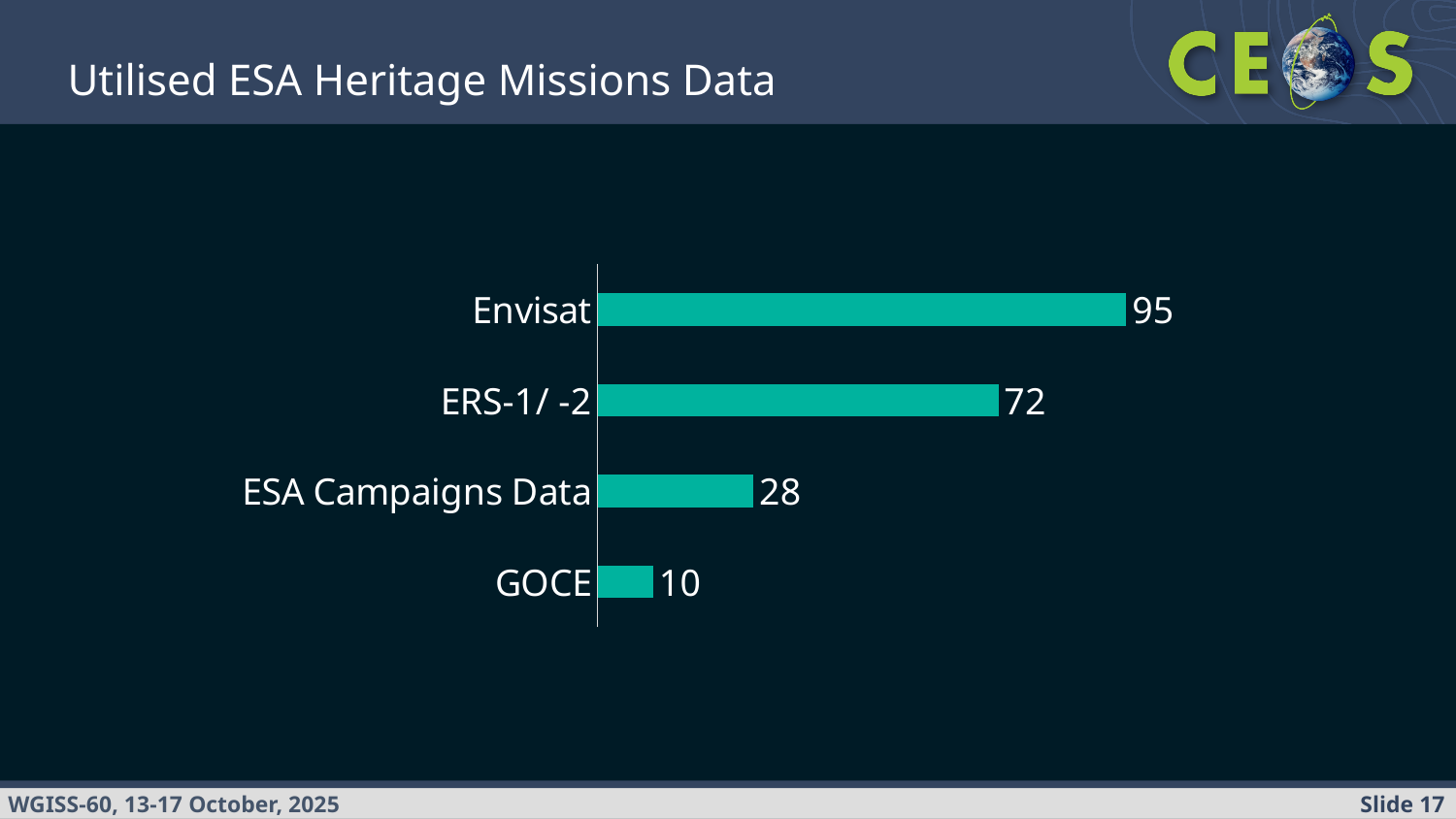
What is the value for GOCE? 10 Which is larger, the value for ERS-1/ -2 or the value for ESA Campaigns Data? ERS-1/ -2 How many categories are shown in the chart? 4 What kind of chart is shown on the slide? Bar chart Which category has the highest value? Envisat What is the value for Envisat? 95 What is the value for ESA Campaigns Data? 28 Which category has the lowest value? GOCE What is the difference between the values for Envisat and ERS-1/ -2? 23 What is the difference between the values for ESA Campaigns Data and GOCE? 18 What is the title of the slide containing the chart? Utilised ESA Heritage Missions Data What is the value for ERS-1/ -2? 72